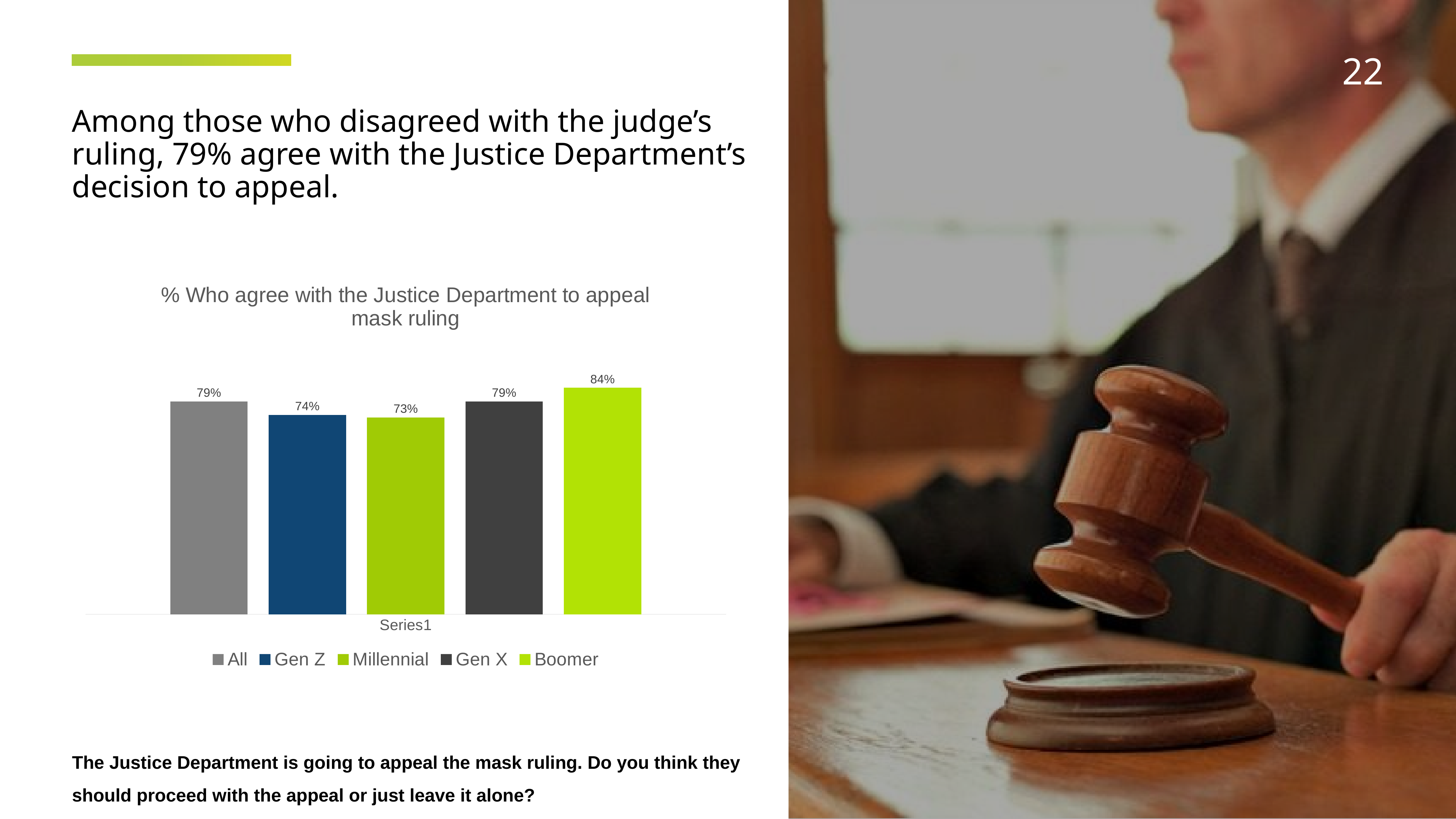
What is the difference between the Boomer value and the Millennial value? 11% What is the difference between the Gen X value and the Gen Z value? 5% What is the value shown for Millennial? 73% How many series does the legend list? 5 Which is larger, the value for Gen Z or the value for Boomer? Boomer What kind of chart is shown on the slide? Bar chart What is the value shown for Gen Z? 74% Which group has the lowest percentage agreeing with the appeal? Millennial What is the value shown for Boomer? 84% What is the title of the chart? % Who agree with the Justice Department to appeal mask ruling What percentage of all respondents agree with the Justice Department to appeal the mask ruling? 79% Which group has the highest percentage agreeing with the appeal? Boomer